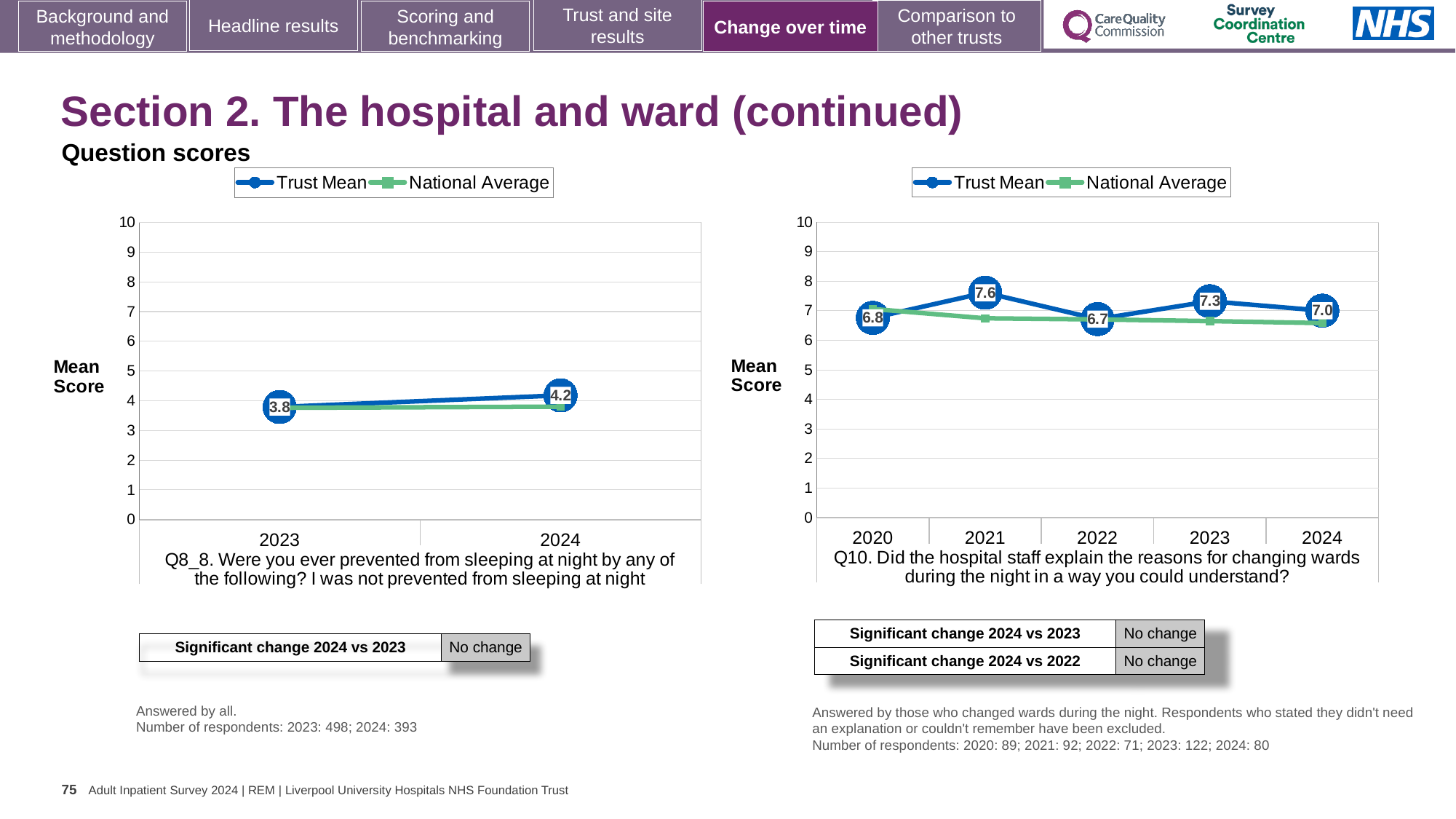
On the Q8_8 chart (left), by how much did the Trust Mean change from 2023 to 2024? 0.4 On the Q8_8 chart (left), what is the Trust Mean score for 2023? 3.8 On the Q10 chart (right), what is the Trust Mean score for 2024? 7.0 On the Q10 chart (right), how many years are plotted on the x axis? 5 On the Q10 chart (right), which year has the highest Trust Mean score? 2021 On the Q10 chart (right), what is the difference between the Trust Mean in 2021 and in 2022? 0.9 On the Q8_8 chart (left), is the Trust Mean for 2024 greater or less than 5? less On the Q8_8 chart (left), does the Trust Mean rise or fall from 2023 to 2024? rise On the Q10 chart (right), what is the Trust Mean score for 2021? 7.6 On the Q8_8 chart (left), what is the Trust Mean score for 2024? 4.2 On the Q10 chart (right), which year has the lowest Trust Mean score? 2022 How many series does the legend of the Q10 chart (right) list? 2